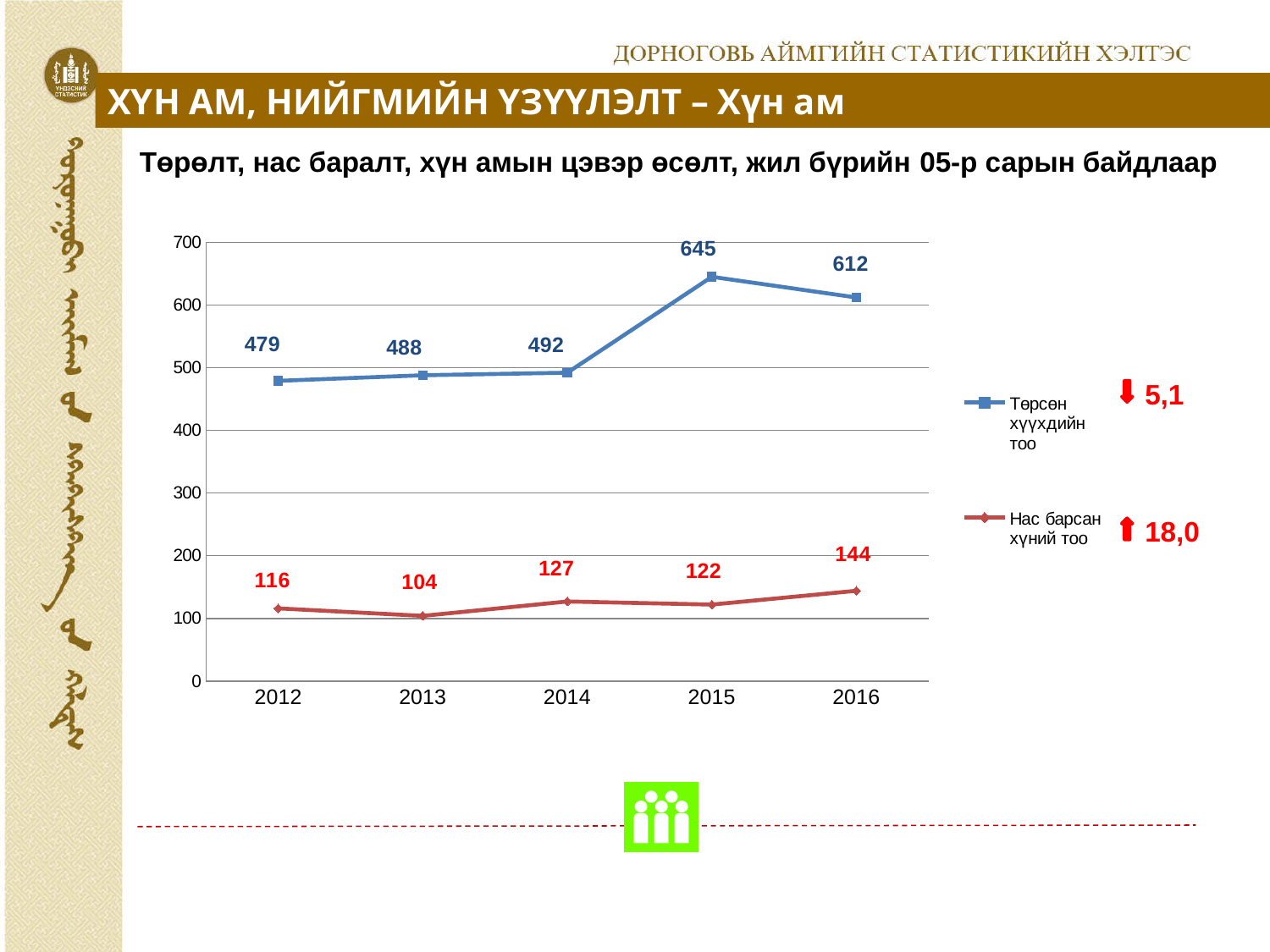
Does Төрсөн хүүхдийн тоо rise or fall from 2012 to 2015? Rise What is the value of Төрсөн хүүхдийн тоо in 2015? 645 How many years are shown on the x axis? 5 In which year is Төрсөн хүүхдийн тоо highest? 2015 What is the difference between Төрсөн хүүхдийн тоо in 2015 and 2016? 33 What is the value of Төрсөн хүүхдийн тоо in 2012? 479 What is the difference between Нас барсан хүний тоо in 2016 and 2012? 28 In which year is Нас барсан хүний тоо lowest? 2013 What is the value of Нас барсан хүний тоо in 2013? 104 How many series does the legend list? 2 Which is larger: Нас барсан хүний тоо in 2014 or in 2015? 2014 What kind of chart is shown? Line chart